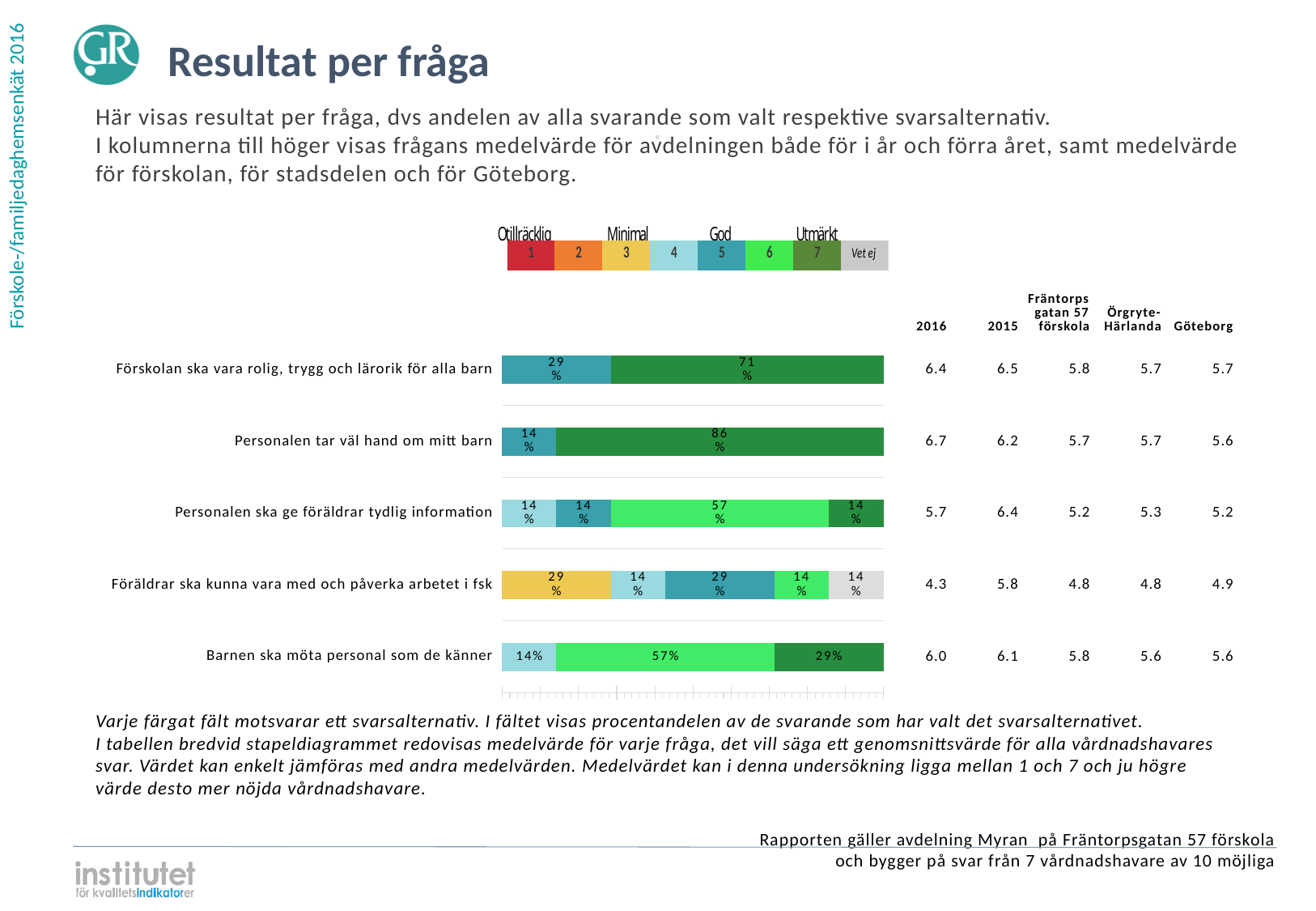
What is the title of the slide? Resultat per fråga What is the Göteborg mean value shown for 'Personalen tar väl hand om mitt barn'? 5.6 What percentage of respondents chose the yellow alternative (3) for 'Föräldrar ska kunna vara med och påverka arbetet i fsk'? 29% How many answer alternatives does the colour legend above the chart list? 8 Which question has the largest share of respondents choosing the dark green alternative (7)? Personalen tar väl hand om mitt barn What is the difference between the 71% and 29% segments for 'Förskolan ska vara rolig, trygg och lärorik för alla barn'? 42 percentage points What percentage of respondents chose the dark green alternative (7, Utmärkt) for 'Personalen tar väl hand om mitt barn'? 86% What kind of chart is shown on the slide? stacked bar chart What is the 2016 mean value shown for 'Föräldrar ska kunna vara med och påverka arbetet i fsk'? 4.3 What percentage of respondents chose the light green alternative (6) for 'Personalen ska ge föräldrar tydlig information'? 57% How many questions (categories) are plotted in the bar chart? 5 Which is larger for 'Barnen ska möta personal som de känner': the light green (6) segment or the dark green (7) segment? the light green (6) segment